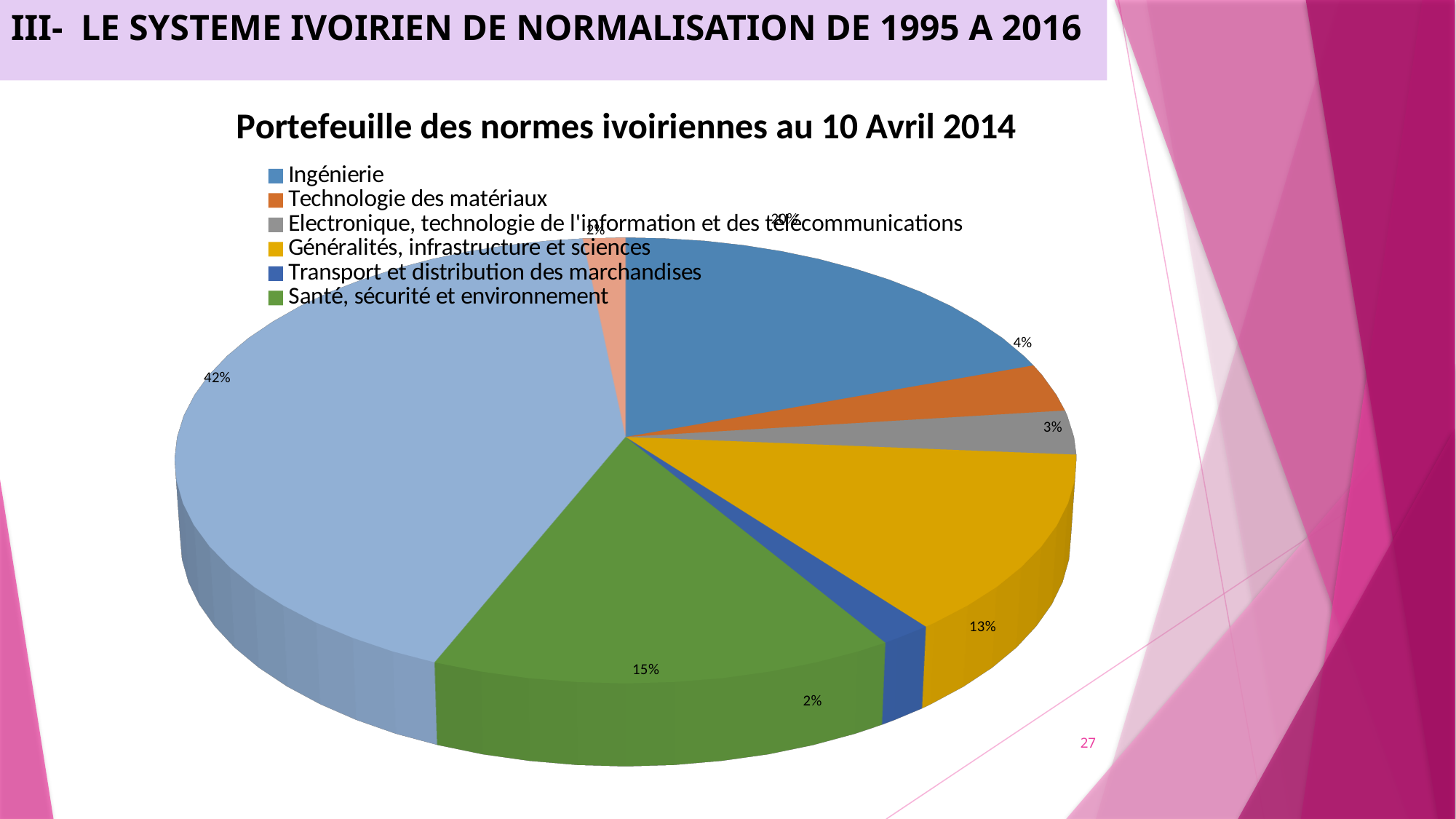
What type of chart is shown on the slide? pie chart What percentage is shown for Généralités, infrastructure et sciences? 13% By how many percentage points does Santé, sécurité et environnement exceed Généralités, infrastructure et sciences? 2 What is the title of the chart? Portefeuille des normes ivoiriennes au 10 Avril 2014 What colour represents Généralités, infrastructure et sciences in the legend? yellow What percentage is shown for Transport et distribution des marchandises? 2% What percentage is shown for Technologie des matériaux? 4% What percentage is shown for Electronique, technologie de l'information et des télécommunications? 3% How many entries does the chart legend list? 6 Which has the larger share: Santé, sécurité et environnement or Généralités, infrastructure et sciences? Santé, sécurité et environnement What percentage is shown for Santé, sécurité et environnement? 15% What is the largest percentage labelled on the pie chart? 42%